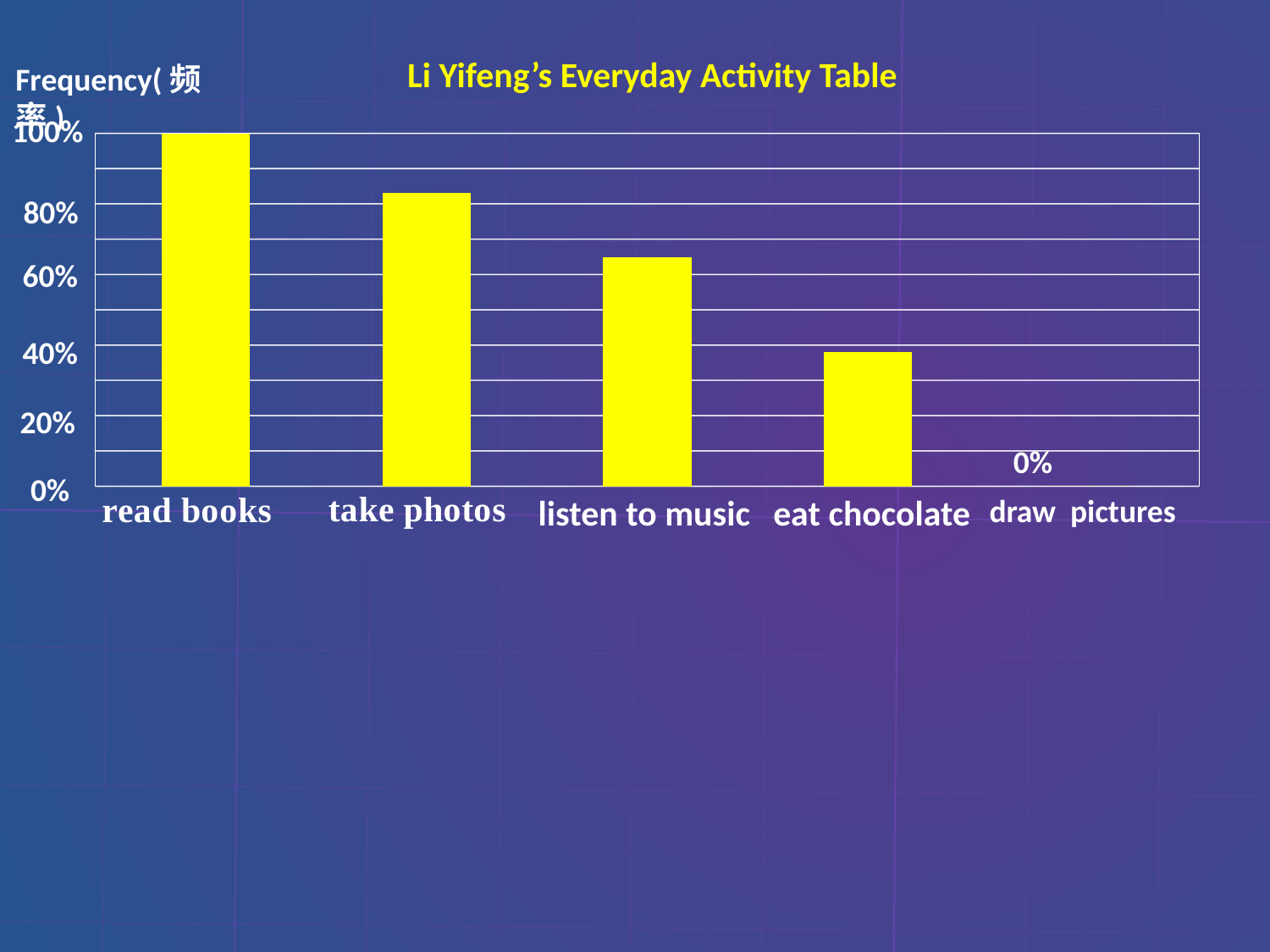
Which has a higher frequency, take photos or listen to music? take photos What is the title of the chart? Li Yifeng's Everyday Activity Table Is the value for take photos greater or less than 80%? greater What is the frequency value for read books? 100% What is the frequency value shown for draw pictures? 0% Is the value for eat chocolate greater or less than 60%? less Is the value for listen to music greater or less than 80%? less Do the bar values rise or fall from left to right along the x axis? fall How many activities are shown on the x axis of the chart? 5 Which activity has the highest frequency in the chart? read books What kind of chart is shown on the slide? bar chart Which activity has the lowest frequency in the chart? draw pictures